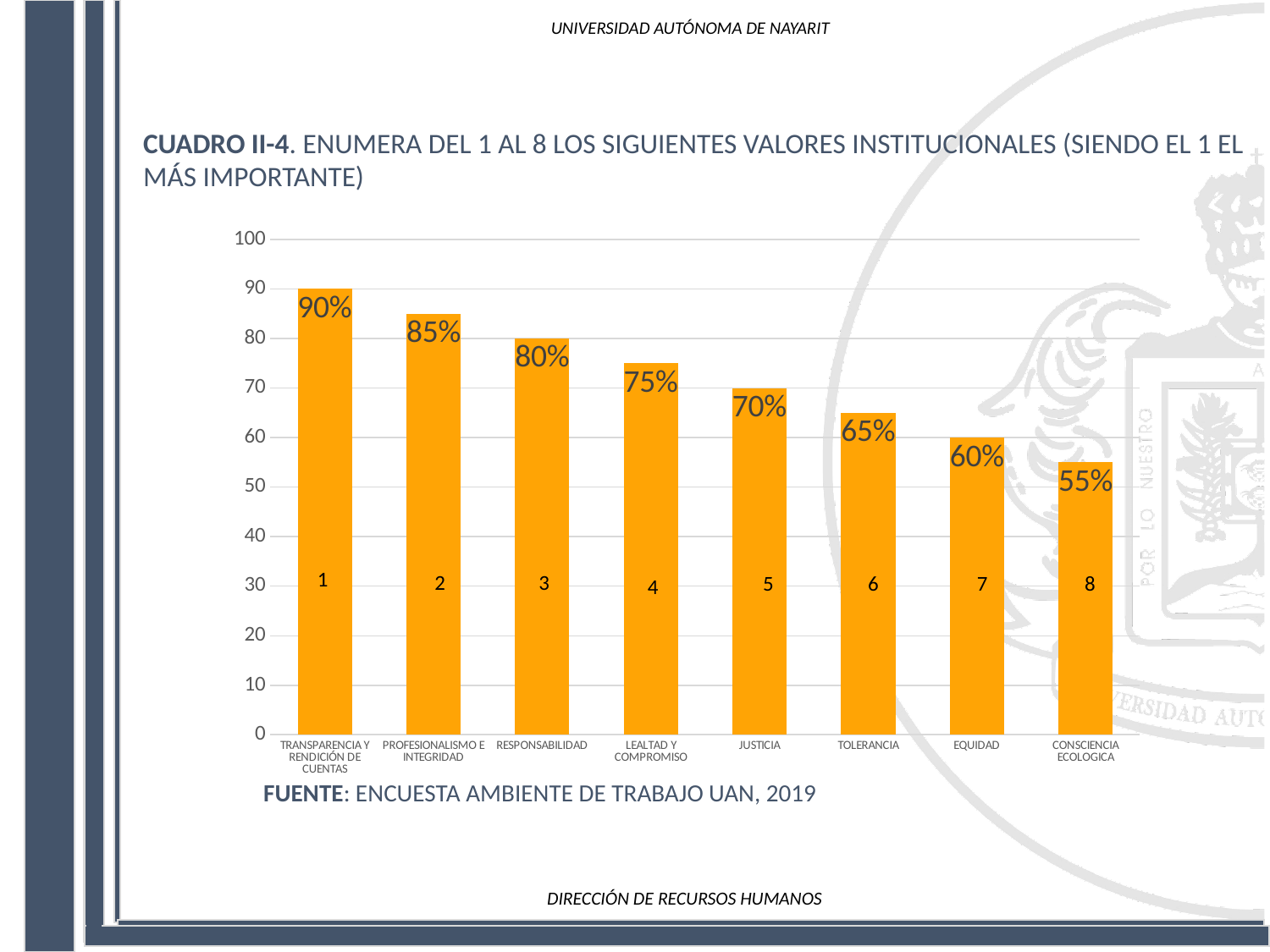
What is the value for TOLERANCIA? 65% Which is larger, the value for JUSTICIA or the value for LEALTAD Y COMPROMISO? LEALTAD Y COMPROMISO What is the value for CONSCIENCIA ECOLOGICA? 55% Which category has the highest value? TRANSPARENCIA Y RENDICIÓN DE CUENTAS What is the difference between the values for PROFESIONALISMO E INTEGRIDAD and EQUIDAD? 25% Is the value for EQUIDAD greater or less than 50? greater What kind of chart is shown on the slide? bar chart Which category has the lowest value? CONSCIENCIA ECOLOGICA Do the values rise or fall from left to right along the x axis? fall What is the value for RESPONSABILIDAD? 80% How many categories are shown on the x axis? 8 What number is printed inside the bar for JUSTICIA? 5